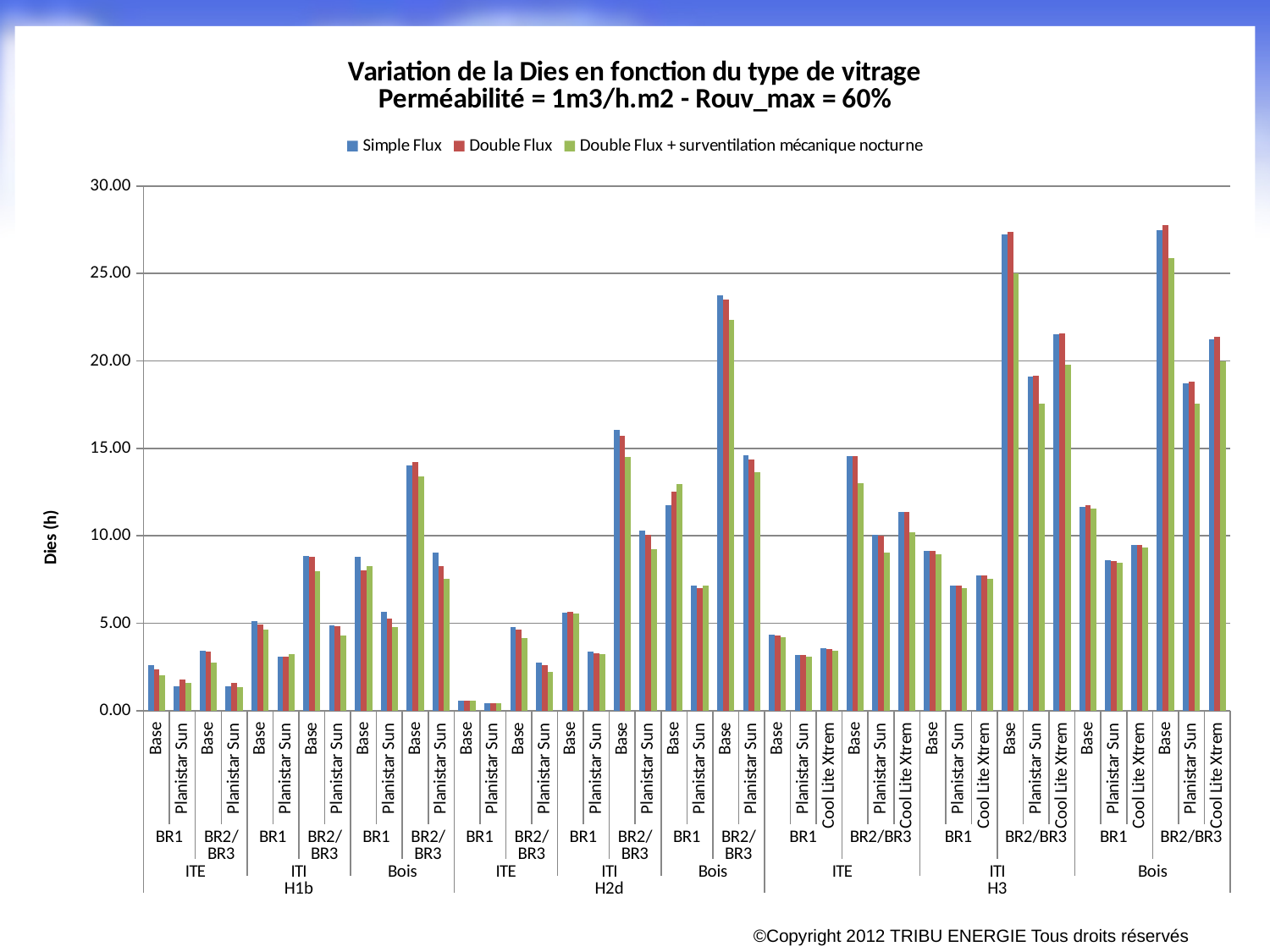
Is the Double Flux value for H3 / Bois / BR2/BR3 / Cool Lite Xtrem greater or less than 20.00? greater Is the Simple Flux value for H1b / ITE / BR1 / Base greater or less than 5.00? less For H3 / Bois / BR2/BR3 / Base, which is larger: the Simple Flux value or the Double Flux + surventilation mécanique nocturne value? Simple Flux What kind of chart is shown on the slide? bar chart How many series does the legend list? 3 Is the Double Flux value for H1b / Bois / BR2/BR3 / Base greater or less than 15.00? less Within H3 / ITI / BR2/BR3, which has the larger Simple Flux value: Base or Planistar Sun? Base Within the H2d zone, which wall type (ITE, ITI or Bois) shows the lowest Dies values? ITE What is the highest value shown on the vertical axis? 30.00 What is the label of the vertical axis? Dies (h)